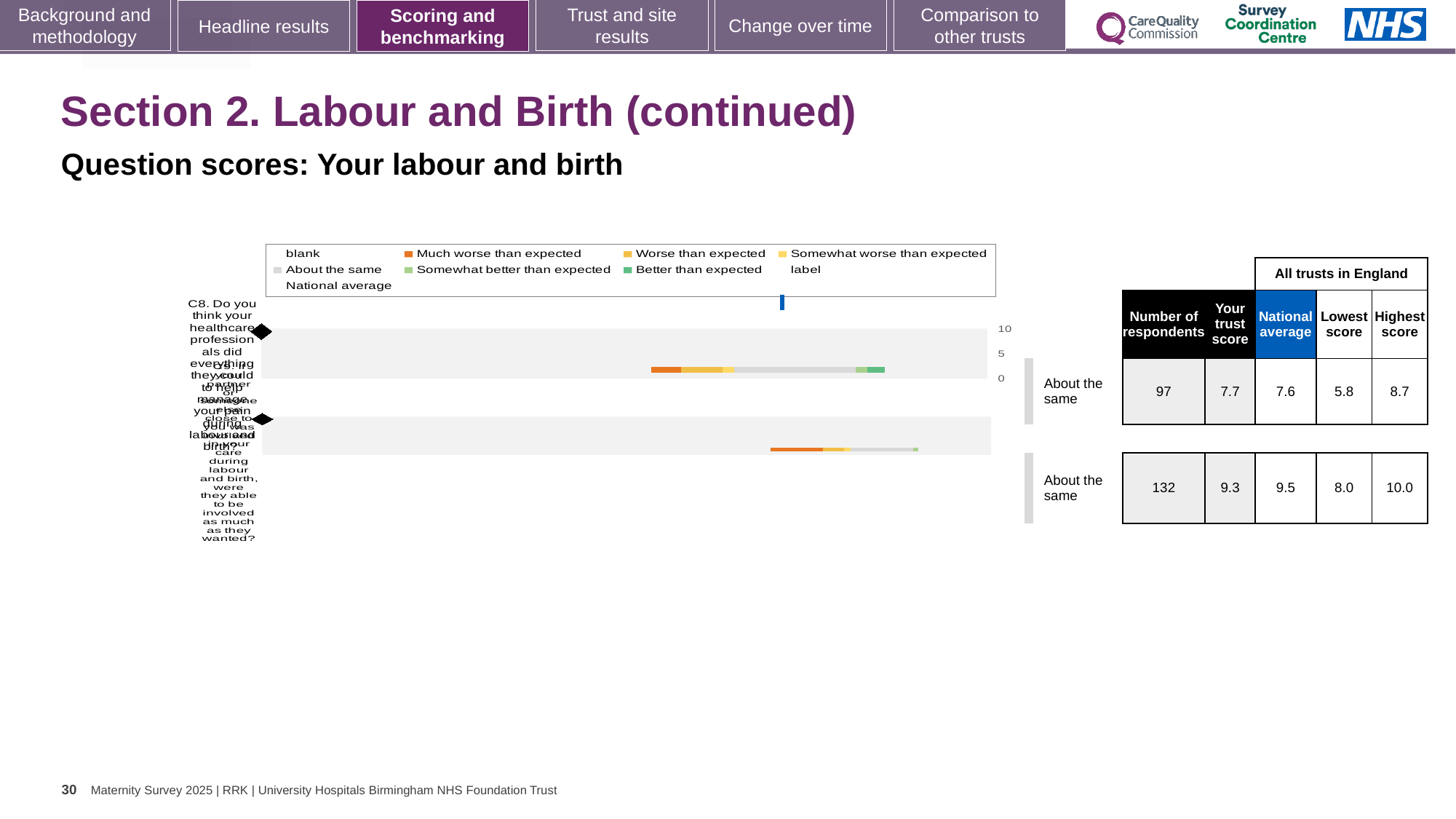
In the table beside the chart, what is the benchmark label shown for both rows? About the same In the table beside the chart, which row has the larger number of respondents, the first or the second? the second In the table beside the chart, what is the number of respondents for the first row? 97 How many entries does the chart's legend list? 9 In the table beside the chart, what is the highest score for the second row? 10.0 What kind of chart is shown on the slide? bar chart In the table beside the chart, what is the national average for the first row? 7.6 How many bars are plotted in the chart? 2 In the table beside the chart, what is the difference between the highest score and the lowest score in the first row? 2.9 In the table beside the chart, what is the trust score for the second row? 9.3 What colour does the legend use for 'Much worse than expected'? orange What colour does the legend use for 'Better than expected'? green